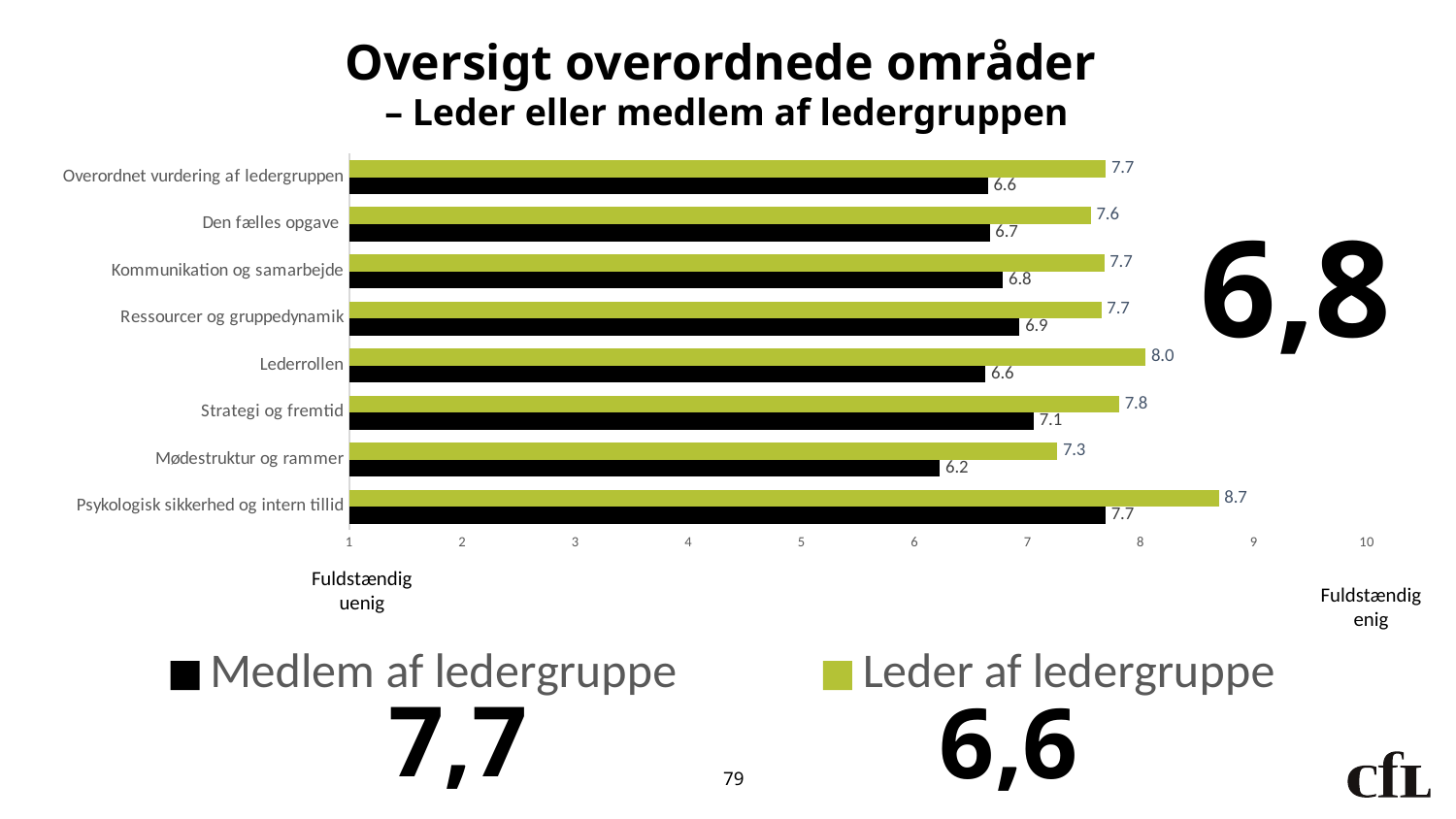
Which is larger on Den fælles opgave: Leder af ledergruppe or Medlem af ledergruppe? Leder af ledergruppe What kind of chart is shown on the slide? Bar chart Which category has the highest value for Leder af ledergruppe? Psykologisk sikkerhed og intern tillid Is the value for Medlem af ledergruppe on Psykologisk sikkerhed og intern tillid greater or less than 7? greater Which colour represents Leder af ledergruppe in the chart? Green What is the value for Leder af ledergruppe on Lederrollen? 8.0 What is the value for Medlem af ledergruppe on Mødestruktur og rammer? 6.2 Which category has the lowest value for Medlem af ledergruppe? Mødestruktur og rammer What is the value for Medlem af ledergruppe on Strategi og fremtid? 7.1 What is the difference between Leder af ledergruppe and Medlem af ledergruppe on Lederrollen? 1.4 How many series does the legend list? 2 How many categories are shown on the chart? 8